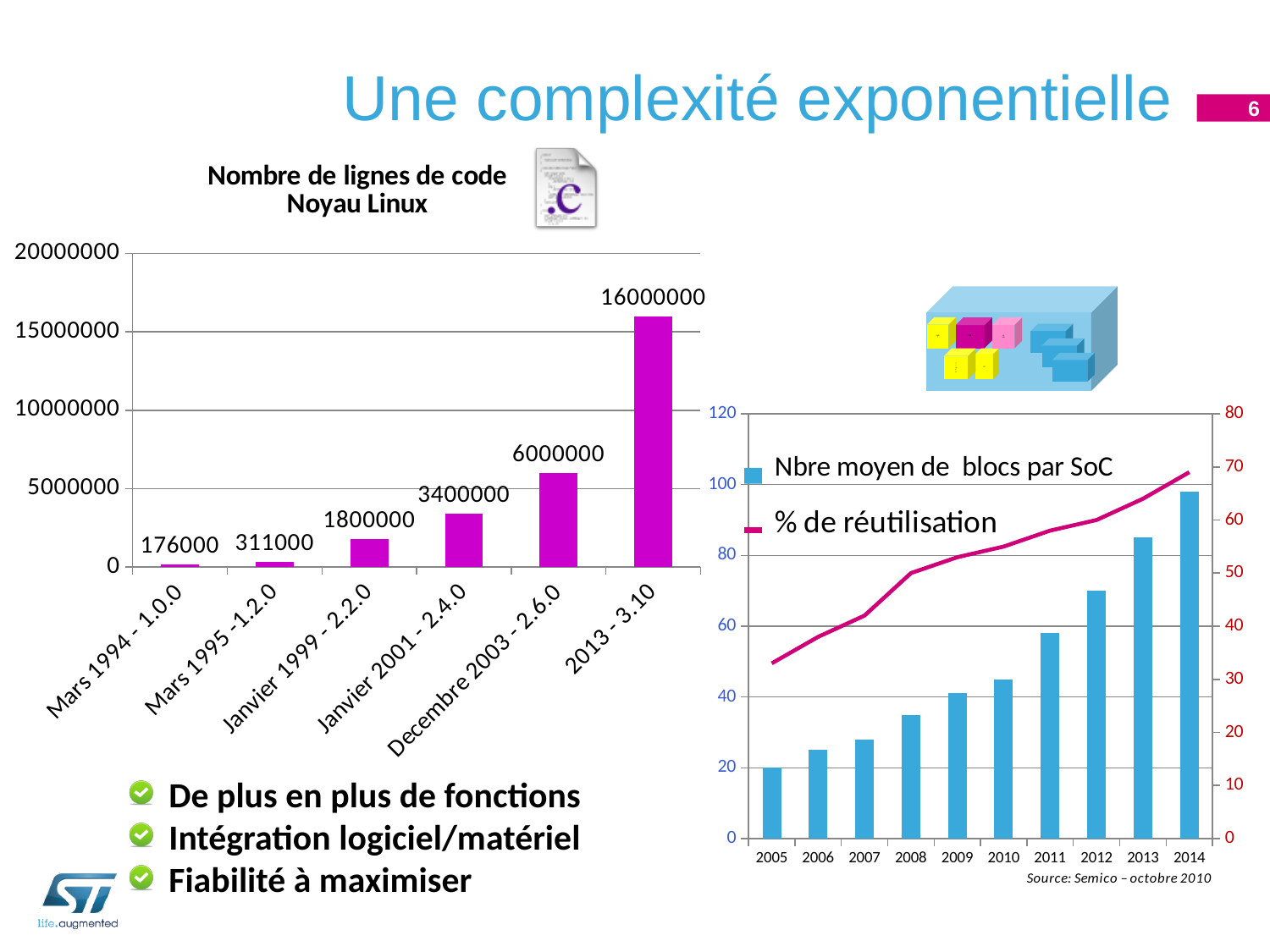
On the right-hand chart, is the 'Nbre moyen de blocs par SoC' value for 2008 greater or less than 40? less On the 'Nombre de lignes de code Noyau Linux' chart, do the values rise or fall from left to right along the x axis? rise On the 'Nombre de lignes de code Noyau Linux' chart, what is the value for '2013 - 3.10'? 16000000 On the 'Nombre de lignes de code Noyau Linux' chart, what is the difference between the values for 'Decembre 2003 - 2.6.0' and 'Janvier 2001 - 2.4.0'? 2600000 On the 'Nombre de lignes de code Noyau Linux' chart, which category has the lowest value? Mars 1994 - 1.0.0 On the 'Nombre de lignes de code Noyau Linux' chart, how many categories are shown on the x axis? 6 On the right-hand chart, how many series does the legend list? 2 On the right-hand chart, how many years are shown on the x axis? 10 What kind of chart is the 'Nombre de lignes de code Noyau Linux' chart? bar chart On the 'Nombre de lignes de code Noyau Linux' chart, what is the value for 'Janvier 1999 - 2.2.0'? 1800000 On the right-hand chart, which year has the highest 'Nbre moyen de blocs par SoC' value? 2014 On the right-hand chart, is the 'Nbre moyen de blocs par SoC' value for 2014 greater or less than 80? greater